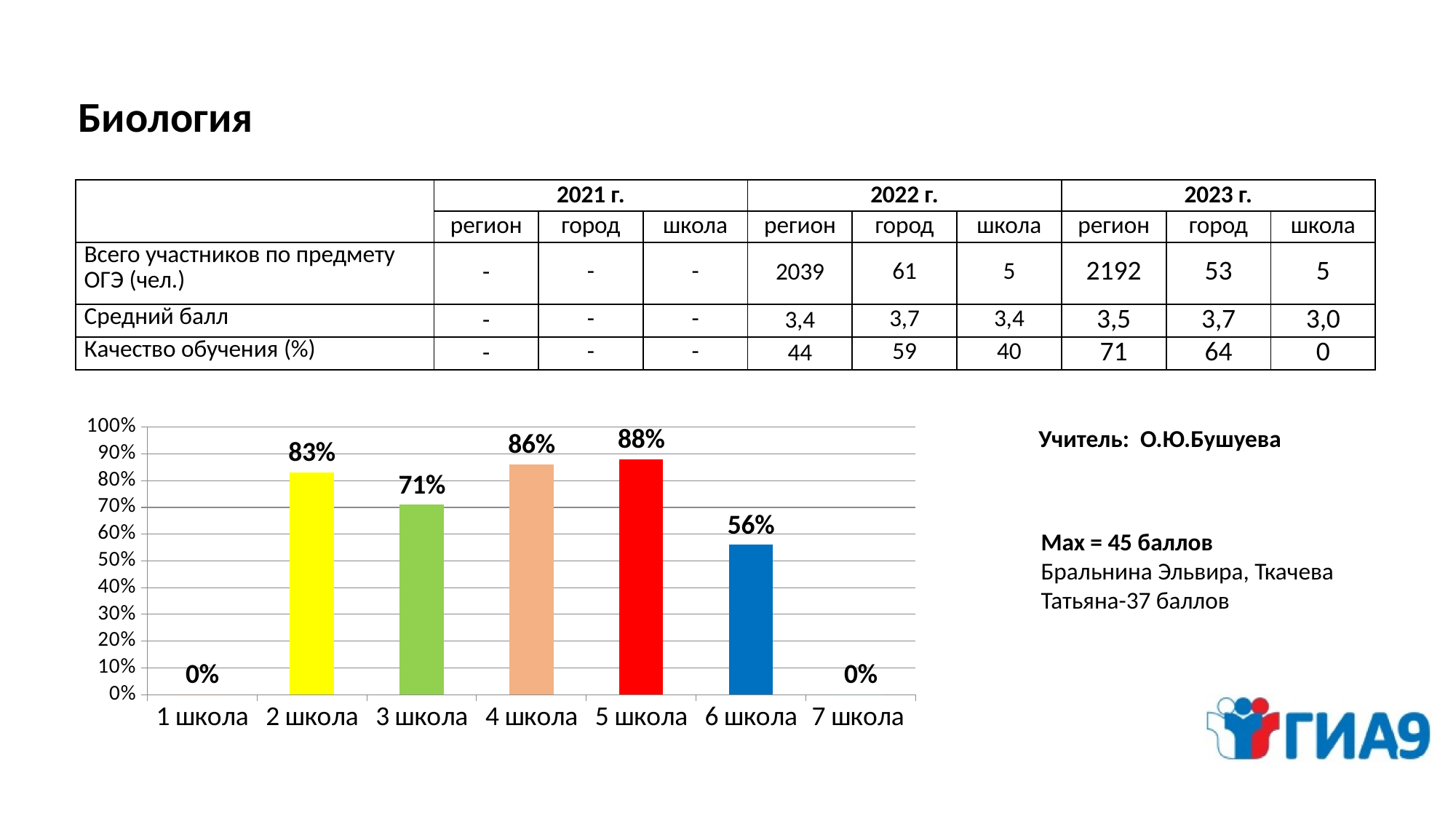
How many schools are shown on the x axis of the bar chart? 7 Which schools have the lowest value in the bar chart? 1 школа and 7 школа What kind of chart is shown on the slide? bar chart Which school has the highest value in the bar chart? 5 школа Which is larger in the bar chart: the value for 3 школа or the value for 6 школа? 3 школа What is the value for 2 школа in the bar chart? 83% What is the difference between the values for 2 школа and 3 школа in the bar chart? 12% What is the value for 4 школа in the bar chart? 86% What is the difference between the values for 5 школа and 6 школа in the bar chart? 32% What is the value for 6 школа in the bar chart? 56% Is the value for 6 школа in the bar chart greater or less than 60%? less What is the value for 3 школа in the bar chart? 71%